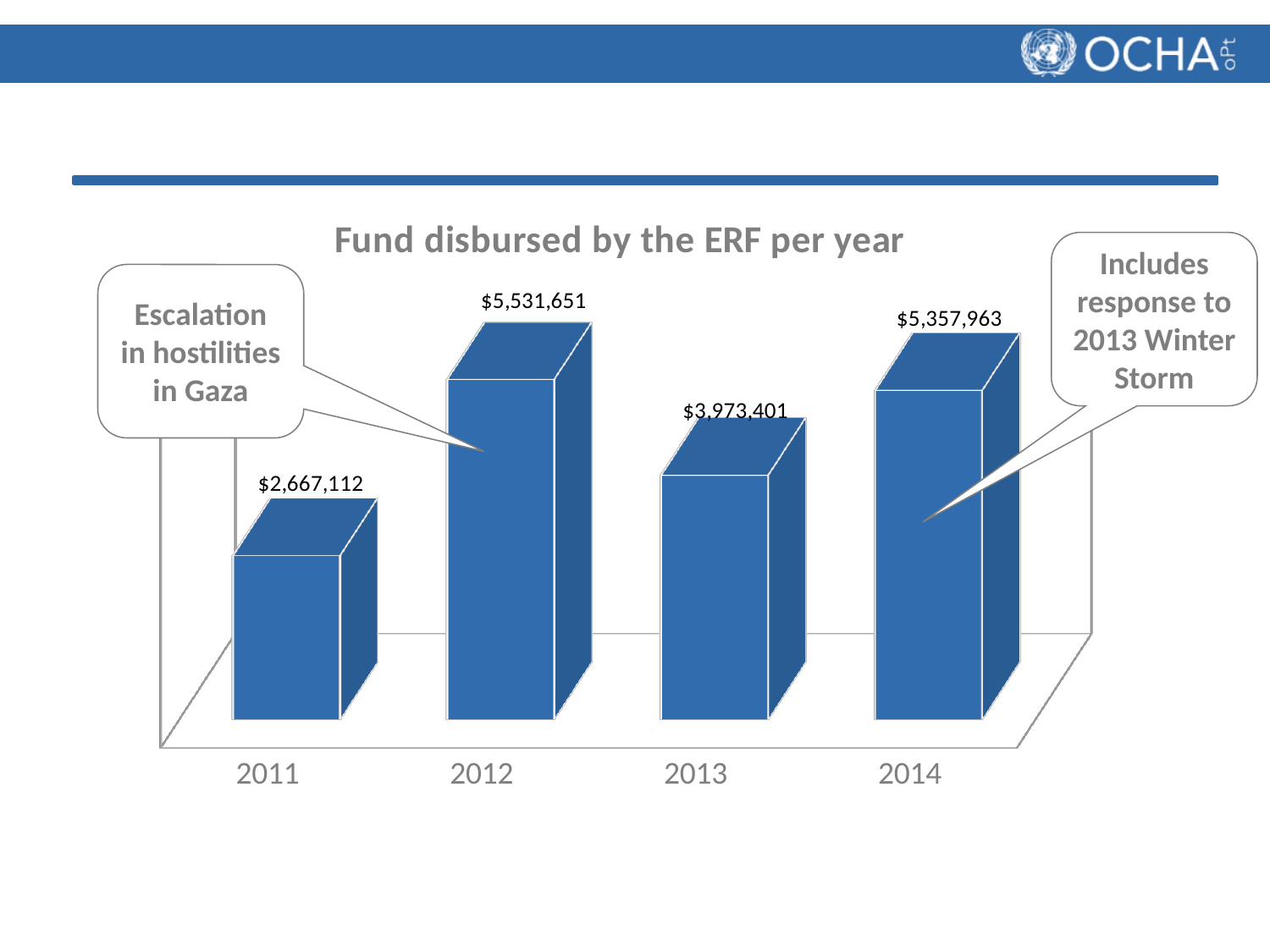
Which year had the lowest fund disbursed by the ERF? 2011 What was the fund disbursed by the ERF in 2014? $5,357,963 What kind of chart is used to show the fund disbursed by the ERF per year? Bar chart How many years are shown on the chart? 4 What is the difference between the fund disbursed in 2014 and in 2013? $1,384,562 What is the difference between the fund disbursed in 2012 and in 2011? $2,864,539 What was the fund disbursed by the ERF in 2012? $5,531,651 Did the fund disbursed rise or fall from 2012 to 2013? Fall Which year had a larger fund disbursed, 2013 or 2014? 2014 Which year had the highest fund disbursed by the ERF? 2012 What was the fund disbursed by the ERF in 2011? $2,667,112 What was the fund disbursed by the ERF in 2013? $3,973,401